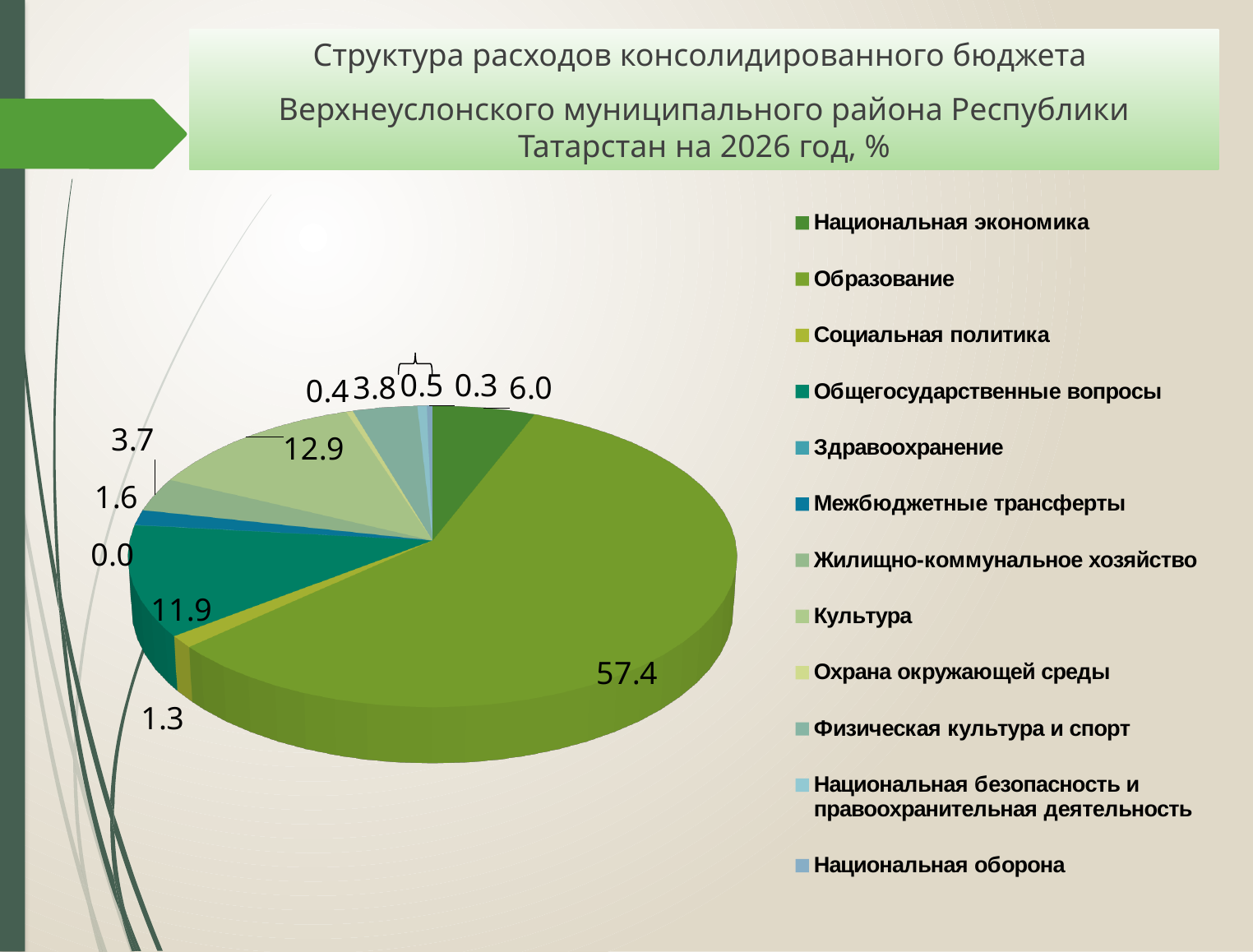
What is the value for Образование? 57.4 What is the value for Культура? 12.9 How many categories does the legend list? 12 What is the value for Социальная политика? 1.3 Which category has the largest share of the pie? Образование What is the value for Общегосударственные вопросы? 11.9 What is the value for Национальная экономика? 6.0 What type of chart is shown on the slide? Pie chart What is the difference between the values for Образование and Культура? 44.5 Which category has the smallest value in the chart? Здравоохранение Which is larger, the value for Культура or the value for Общегосударственные вопросы? Культура What year does the chart title refer to? 2026